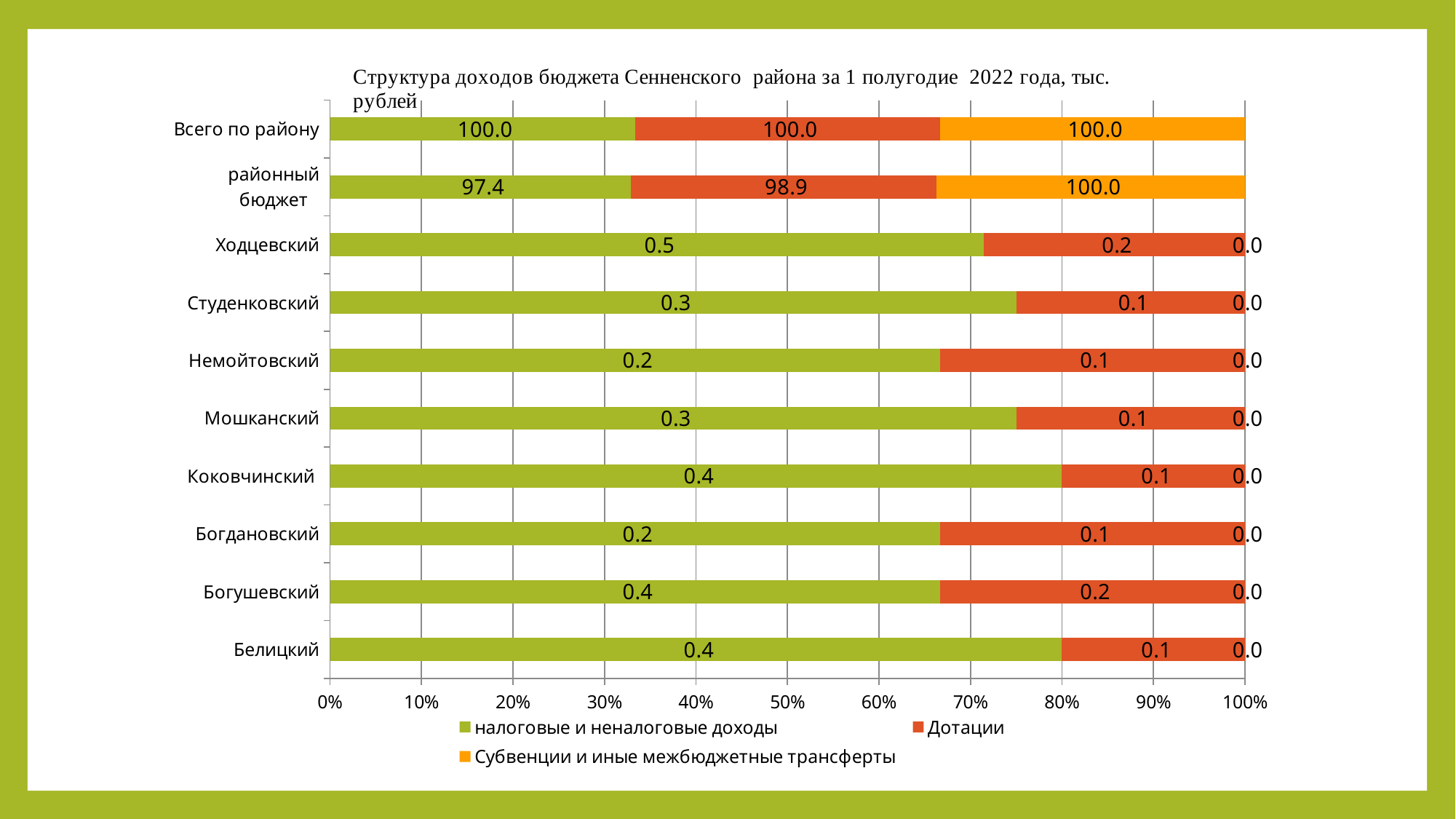
How many series does the legend list? 3 What is the value of "налоговые и неналоговые доходы" for "районный бюджет"? 97.4 Which has the larger "налоговые и неналоговые доходы" value, "Ходцевский" or "Студенковский"? Ходцевский How many categories are listed on the vertical axis of the chart? 10 Which series is shown in orange in the legend? Субвенции и иные межбюджетные трансферты What is the value of "Дотации" for "Богушевский"? 0.2 What kind of chart is shown on the slide? Stacked bar chart What is the value of "налоговые и неналоговые доходы" for "Ходцевский"? 0.5 What is the difference between the "налоговые и неналоговые доходы" values for "Всего по району" and "районный бюджет"? 2.6 Which category has the highest value of "налоговые и неналоговые доходы"? Всего по району What is the value of "Дотации" for "районный бюджет"? 98.9 What is the value of "Субвенции и иные межбюджетные трансферты" for "Всего по району"? 100.0